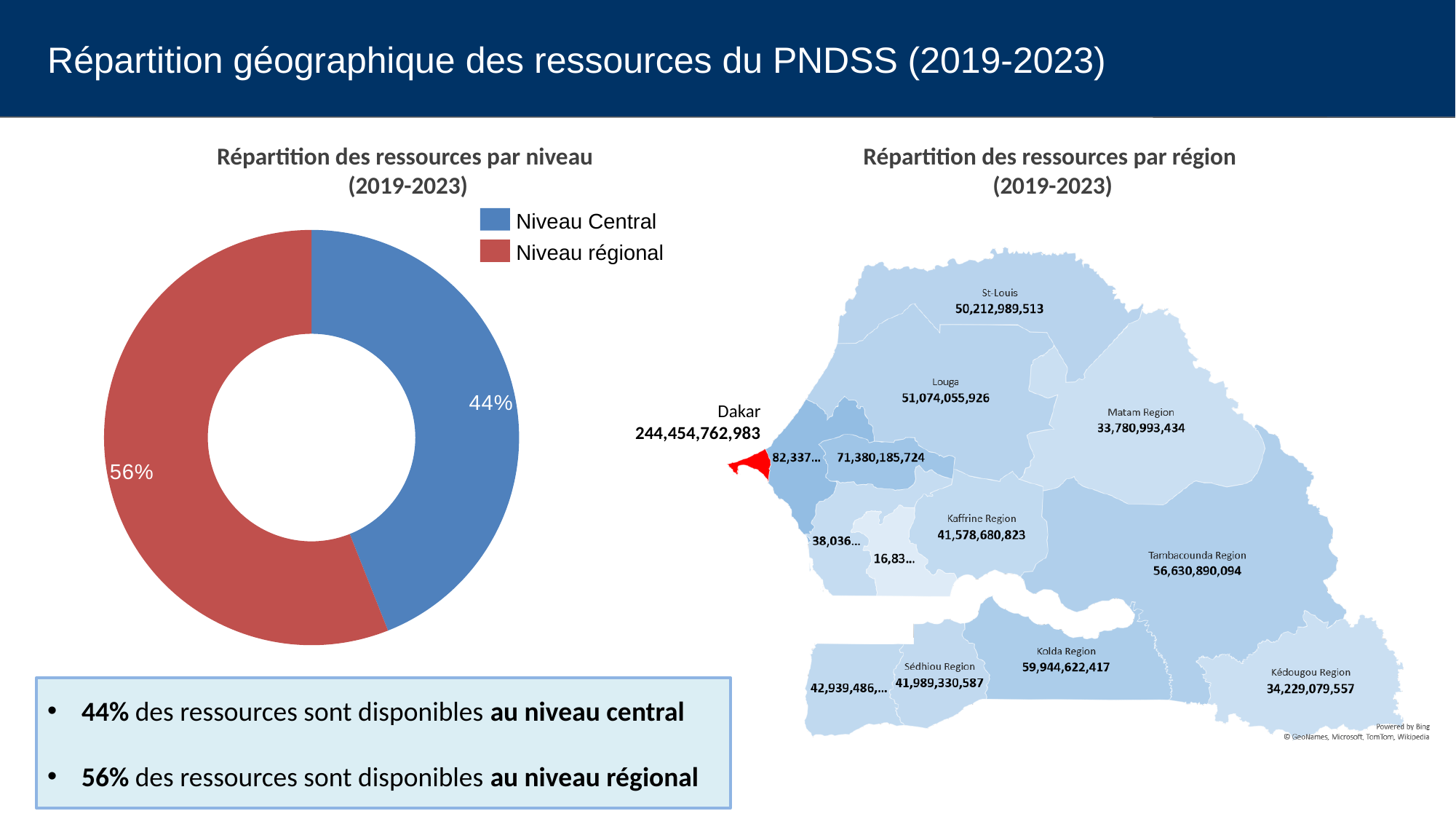
In the map 'Répartition des ressources par région (2019-2023)', which labelled region has the highest value? Dakar In the chart 'Répartition des ressources par niveau (2019-2023)', what share of resources is at the Niveau régional? 56% In the map 'Répartition des ressources par région (2019-2023)', what is the value for Matam Region? 33,780,993,434 In the map 'Répartition des ressources par région (2019-2023)', what is the value for Dakar? 244,454,762,983 In the map 'Répartition des ressources par région (2019-2023)', which has the larger value, Kolda Region or Tambacounda Region? Kolda Region In the chart 'Répartition des ressources par niveau (2019-2023)', what colour represents Niveau régional? Red In the chart 'Répartition des ressources par niveau (2019-2023)', which level has the larger share of resources? Niveau régional In the map 'Répartition des ressources par région (2019-2023)', what is the difference between the values for Louga and St-Louis? 861,066,413 In the chart 'Répartition des ressources par niveau (2019-2023)', what share of resources is at the Niveau Central? 44% In the chart 'Répartition des ressources par niveau (2019-2023)', how many entries does the legend list? 2 What kind of chart is 'Répartition des ressources par niveau (2019-2023)'? Doughnut chart In the map 'Répartition des ressources par région (2019-2023)', what is the value for Kolda Region? 59,944,622,417